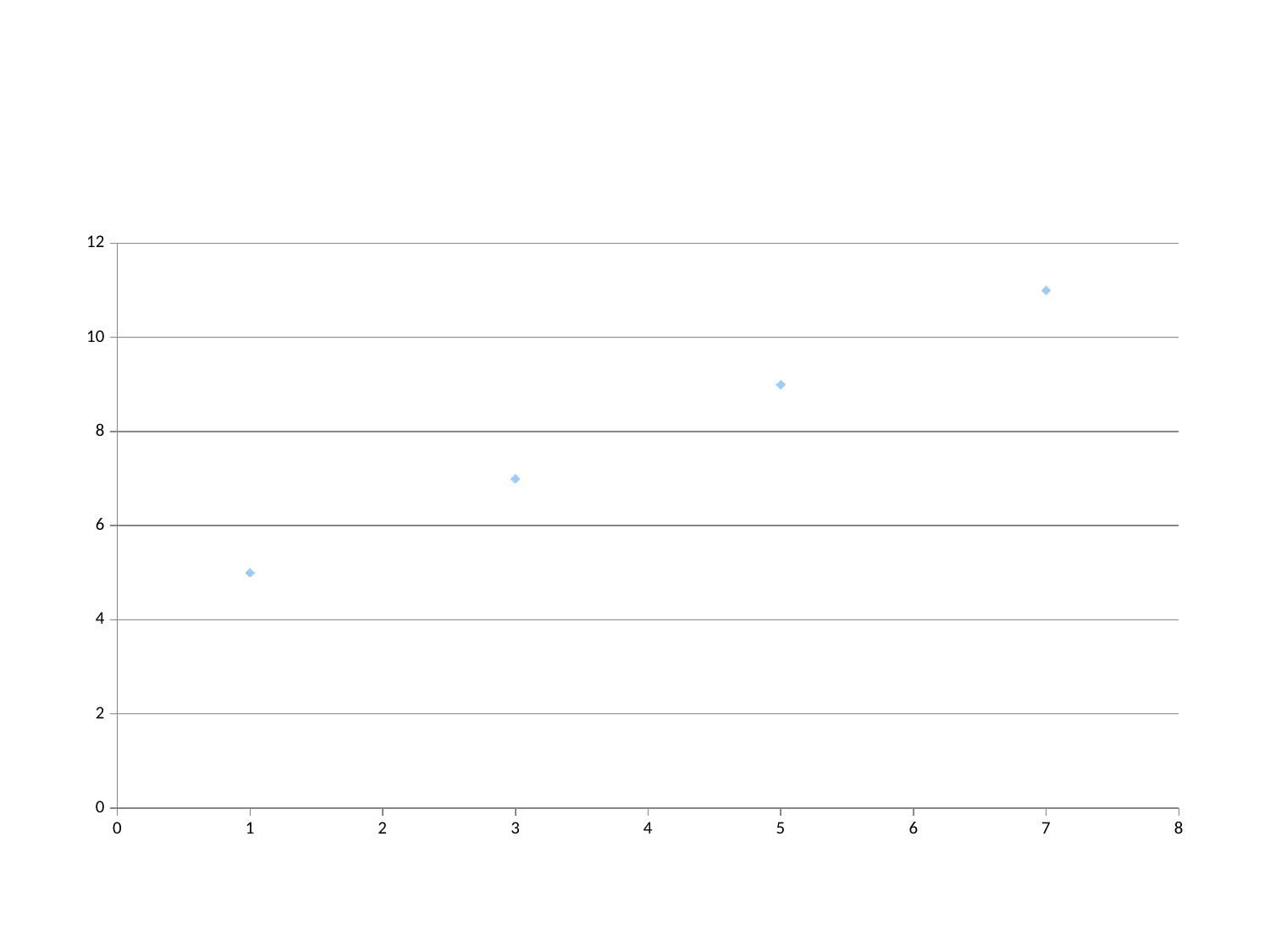
Is the y value of the point at x = 3 greater or less than 8? less At which x value is the highest point plotted? 7 Which point has the larger y value, the one at x = 3 or the one at x = 5? x = 5 What is the highest value shown on the y axis? 12 What kind of chart is shown on the slide? scatter chart At which x value is the lowest point plotted? 1 Is the y value of the point at x = 5 greater or less than 8? greater Is the y value of the point at x = 1 greater or less than 6? less How many data points are plotted on the chart? 4 What is the highest value shown on the x axis? 8 Do the plotted values rise or fall as x increases along the x axis? rise